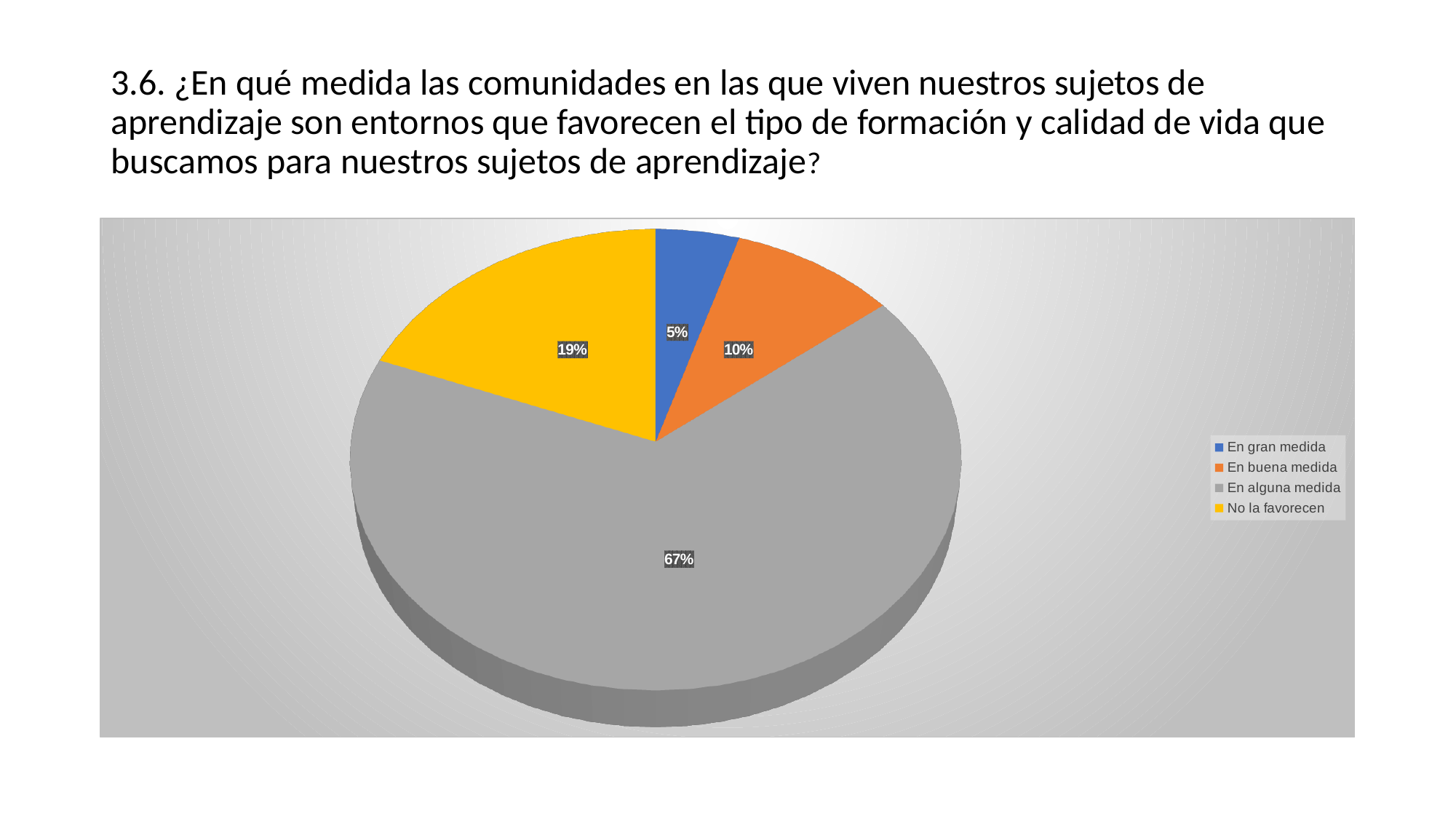
What percentage of the pie corresponds to "En alguna medida"? 67% What colour is the slice for "No la favorecen"? Yellow What percentage of the pie corresponds to "No la favorecen"? 19% What percentage of the pie corresponds to "En buena medida"? 10% Which category has the largest share of the pie? En alguna medida What percentage of the pie corresponds to "En gran medida"? 5% What is the difference in percentage points between "En alguna medida" and "No la favorecen"? 48 Which category has the smallest share of the pie? En gran medida How many categories does the pie chart show? 4 Which legend entry is shown in blue? En gran medida Which is larger, the share for "En buena medida" or the share for "No la favorecen"? No la favorecen What type of chart is shown on the slide? Pie chart